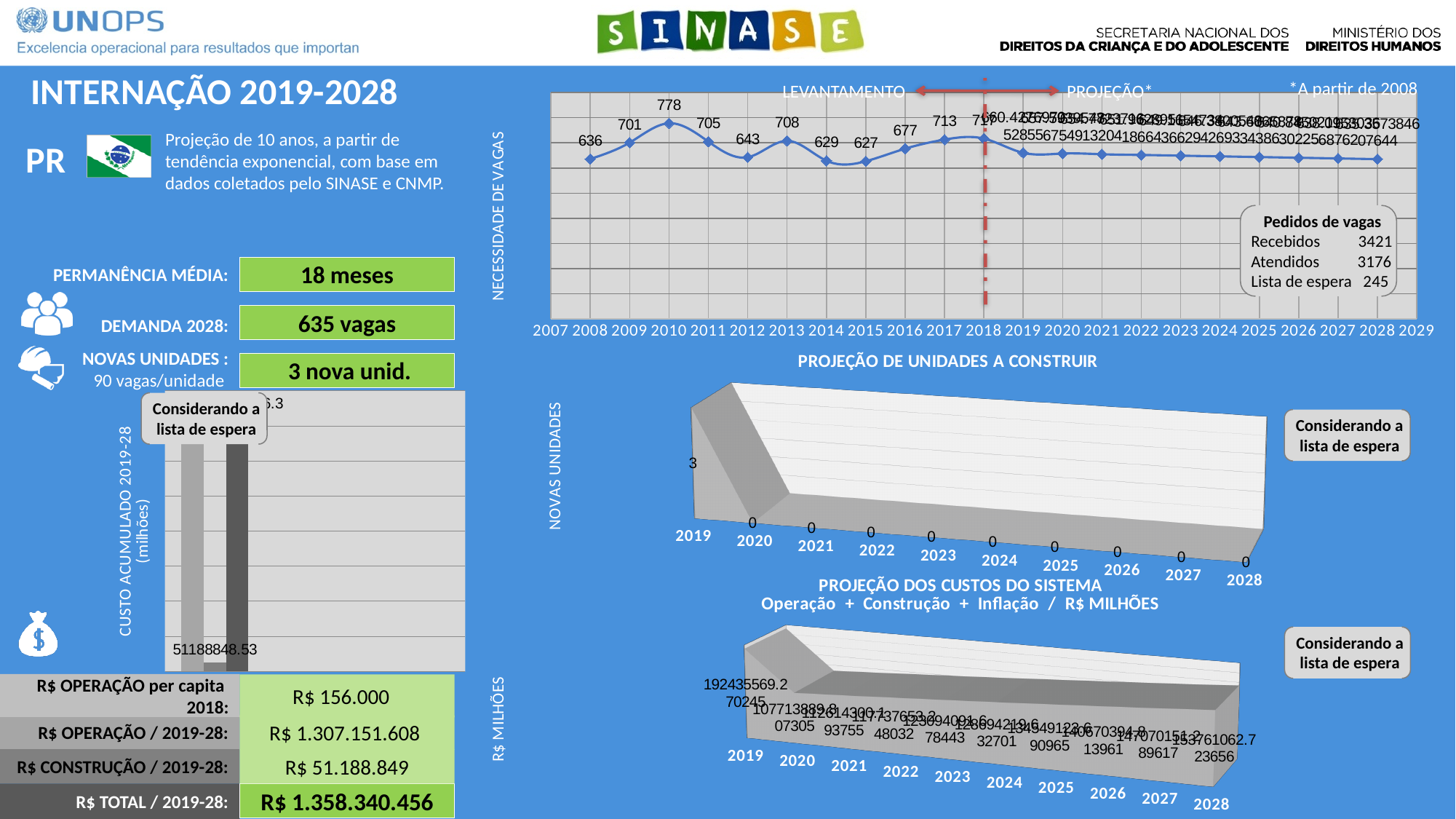
In the PROJEÇÃO DE UNIDADES A CONSTRUIR chart, how many years are shown on the x axis? 10 In the PROJEÇÃO DOS CUSTOS DO SISTEMA chart, what is the value for 2019? 192435569.2 In the PROJEÇÃO DOS CUSTOS DO SISTEMA chart, what is the value for 2028? 153761062.7 In the NECESSIDADE DE VAGAS line chart, what is the difference between the values for 2010 and 2008? 142 In the NECESSIDADE DE VAGAS line chart, what is the value for 2010? 778 In the PROJEÇÃO DE UNIDADES A CONSTRUIR chart, what is the value for 2019? 3 What kind of chart is the NECESSIDADE DE VAGAS chart at the top right? line chart In the NECESSIDADE DE VAGAS line chart, among the years 2008 to 2017, which year has the lowest value? 2015 In the NECESSIDADE DE VAGAS line chart, what is the value for 2015? 627 In the NECESSIDADE DE VAGAS line chart, which is larger, the value for 2013 or the value for 2011? 2013 In the NECESSIDADE DE VAGAS line chart, what is the value for 2008? 636 In the NECESSIDADE DE VAGAS line chart, which year has the highest value? 2010